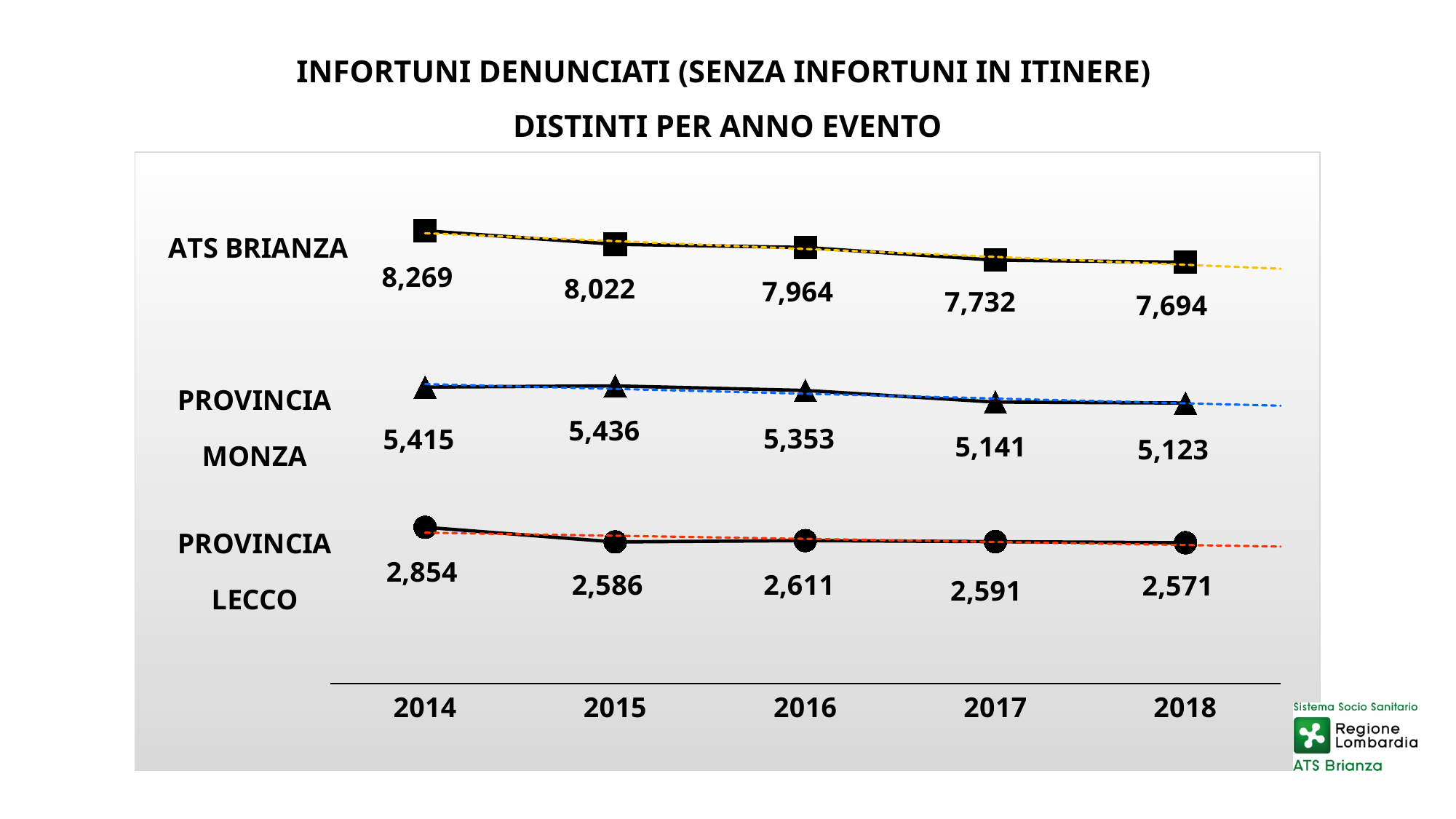
What is the difference between the ATS BRIANZA values in 2014 and 2018? 575 In which year is the PROVINCIA LECCO value highest? 2014 In which year is the PROVINCIA MONZA value highest? 2015 What is the difference between the PROVINCIA LECCO values in 2014 and 2015? 268 What is the value for PROVINCIA LECCO in 2018? 2,571 Which is larger, the PROVINCIA MONZA value in 2015 or in 2017? 2015 What is the value for ATS BRIANZA in 2014? 8,269 What kind of chart is shown on the slide? line chart What is the value for PROVINCIA MONZA in 2016? 5,353 In which year is the ATS BRIANZA value lowest? 2018 How many series are plotted on the chart? 3 How many years are shown on the x axis? 5